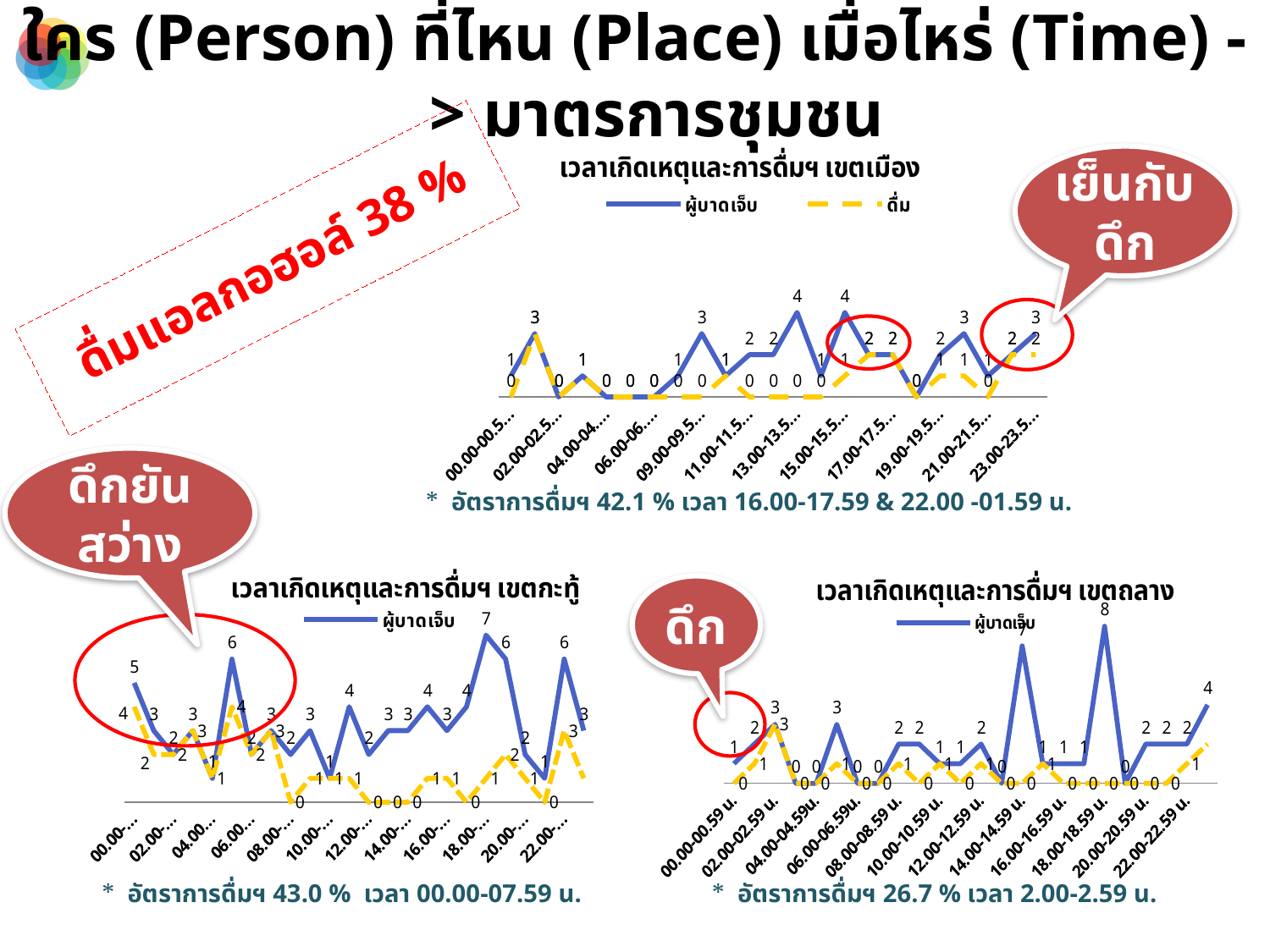
In the เวลาเกิดเหตุและการดื่มฯ เขตถลาง chart, what is the ผู้บาดเจ็บ value at 18.00-18.59 น.? 8 In the เวลาเกิดเหตุและการดื่มฯ เขตเมือง chart, what is the highest value reached by the ผู้บาดเจ็บ line? 4 How many series does the legend of the เวลาเกิดเหตุและการดื่มฯ เขตเมือง chart list? 2 In the เวลาเกิดเหตุและการดื่มฯ เขตเมือง chart, what are the two legend entries? ผู้บาดเจ็บ and ดื่ม What is the difference between the peak ผู้บาดเจ็บ value in the เขตถลาง chart and the peak ผู้บาดเจ็บ value in the เขตกะทู้ chart? 1 In the เวลาเกิดเหตุและการดื่มฯ เขตถลาง chart, what is the ผู้บาดเจ็บ value at 00.00-00.59 น.? 1 Which chart has the higher peak ผู้บาดเจ็บ value, เขตกะทู้ or เขตถลาง? เขตถลาง In the เวลาเกิดเหตุและการดื่มฯ เขตถลาง chart, what is the highest value reached by the ผู้บาดเจ็บ line? 8 How many charts are shown on the slide? 3 In the เวลาเกิดเหตุและการดื่มฯ เขตกะทู้ chart, what is the highest value reached by the ผู้บาดเจ็บ line? 7 What is the title of the chart in the bottom-left of the slide? เวลาเกิดเหตุและการดื่มฯ เขตกะทู้ What kind of chart is used for เวลาเกิดเหตุและการดื่มฯ เขตเมือง? Line chart